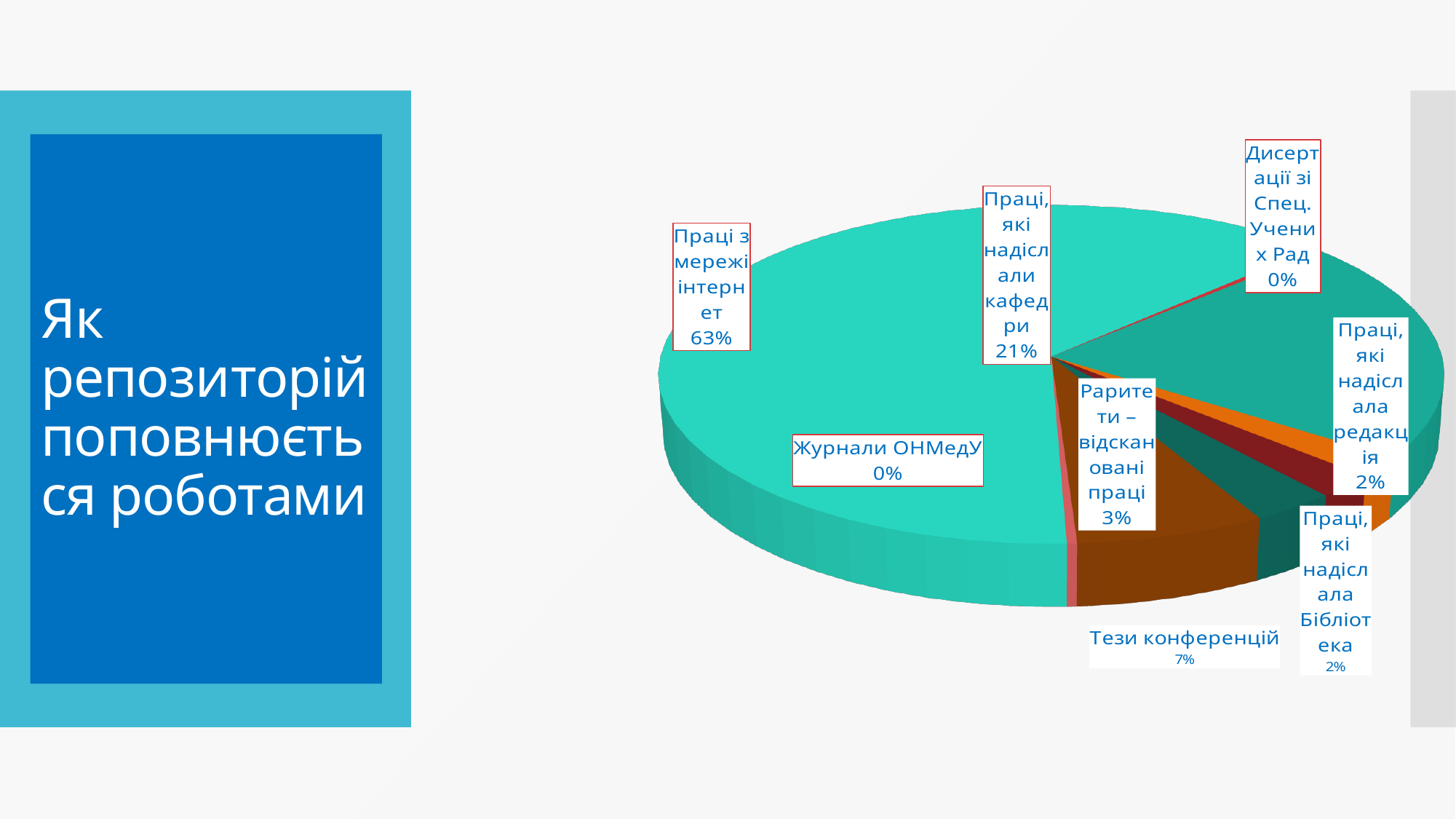
Which two categories are labelled with 0%? Журнали ОНМедУ and Дисертації зі Спец. Учених Рад What is the title text on the left side of the slide? Як репозиторій поповнюється роботами What is the difference in percentage points between "Праці з мережі інтернет" and "Праці, які надіслали кафедри"? 42 Which is larger: the share for "Тези конференцій" or the share for "Раритети – відскановані праці"? Тези конференцій What percentage is shown for "Праці, які надіслала Бібліотека"? 2% What percentage is shown for "Раритети – відскановані праці"? 3% What kind of chart is shown on the slide? pie chart What percentage is shown for "Тези конференцій"? 7% What share of the pie does "Праці з мережі інтернет" have? 63% How many categories are labelled on the pie chart? 8 What share of the pie does "Праці, які надіслали кафедри" have? 21% Which category has the largest share of the pie? Праці з мережі інтернет